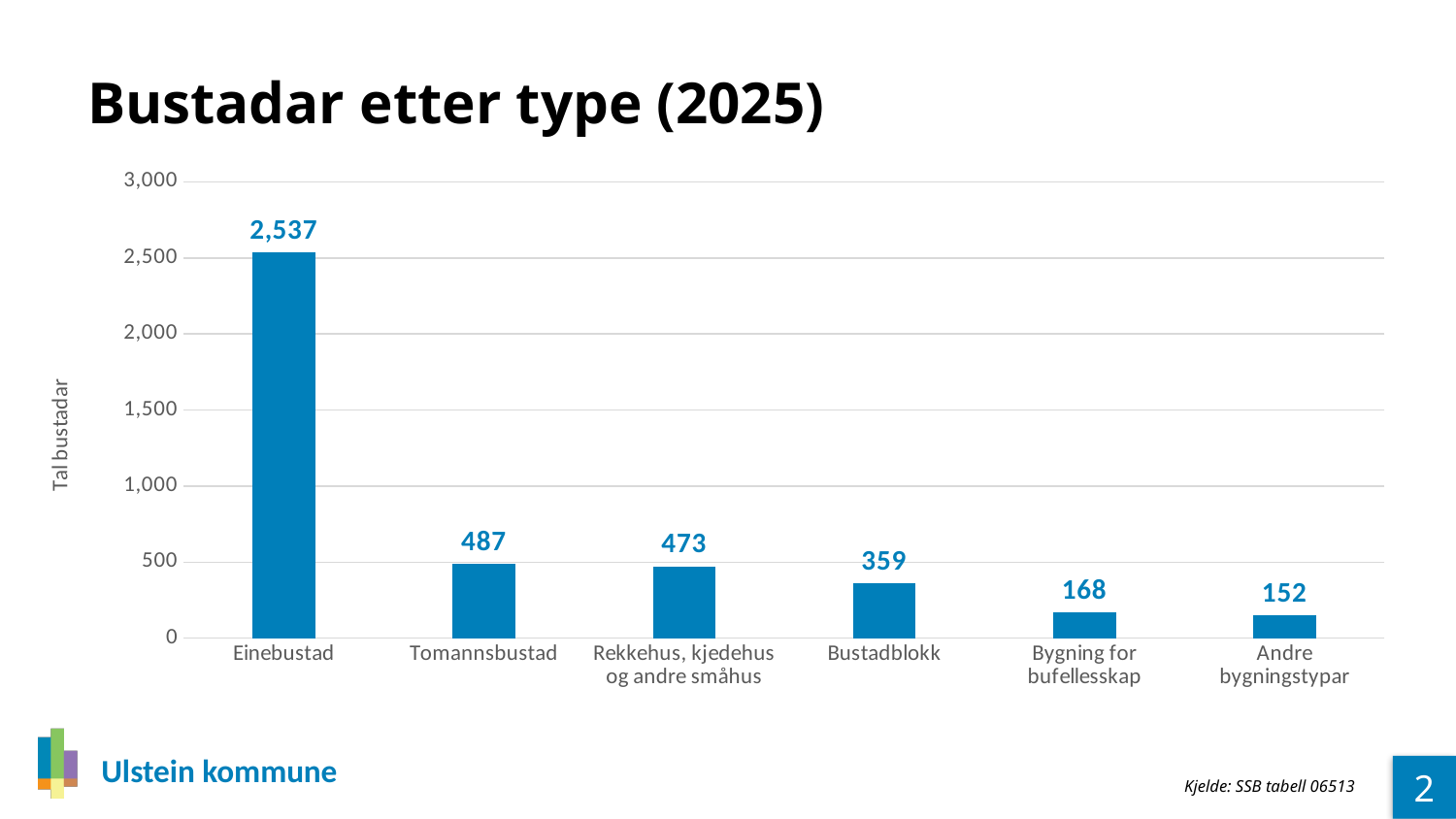
What is the value for Bustadblokk? 359 Which category has the highest value? Einebustad Which category has the lowest value? Andre bygningstypar What is the value for Einebustad? 2,537 What is the difference between the values for Tomannsbustad and Rekkehus, kjedehus og andre småhus? 14 What kind of chart is shown on the slide? Bar chart How many categories are shown on the x axis? 6 What is the title of the chart? Bustadar etter type (2025) What is the value for Bygning for bufellesskap? 168 What is the difference between the values for Einebustad and Bustadblokk? 2,178 What is the value for Tomannsbustad? 487 Which is larger, the value for Bustadblokk or the value for Bygning for bufellesskap? Bustadblokk